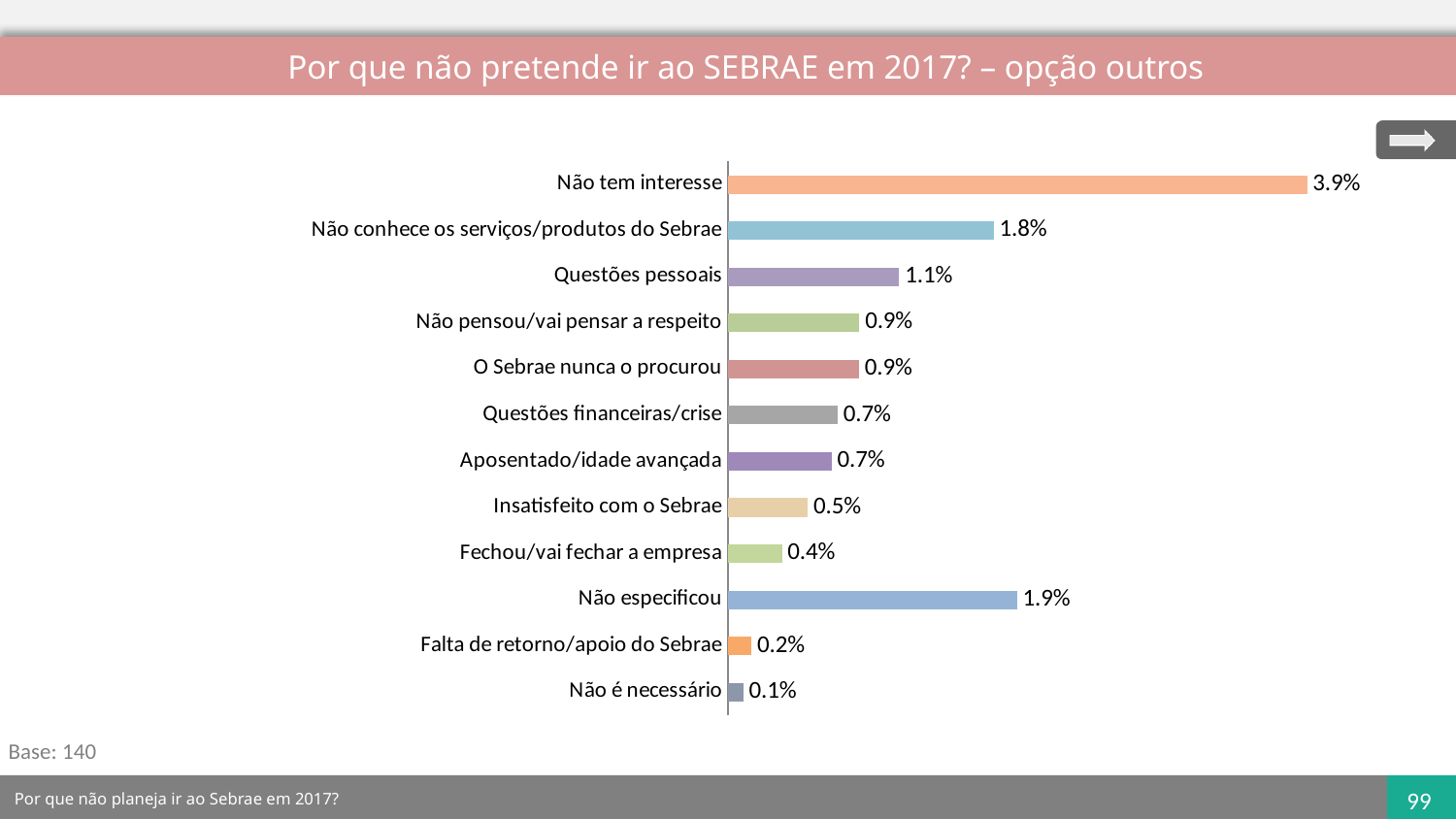
What kind of chart is shown on the slide? Bar chart Which category has the highest value? Não tem interesse What is the difference between "Não tem interesse" and "Não conhece os serviços/produtos do Sebrae"? 2.1% Which is larger, "Não especificou" or "Não conhece os serviços/produtos do Sebrae"? Não especificou How many categories are shown in the chart? 12 What is the base (number of respondents) stated on the slide? 140 What is the value for "Não especificou"? 1.9% What is the difference between "Questões pessoais" and "Fechou/vai fechar a empresa"? 0.7% Which category has the lowest value? Não é necessário What is the value for "Insatisfeito com o Sebrae"? 0.5% What is the value for "Falta de retorno/apoio do Sebrae"? 0.2% What is the value for "Não tem interesse"? 3.9%